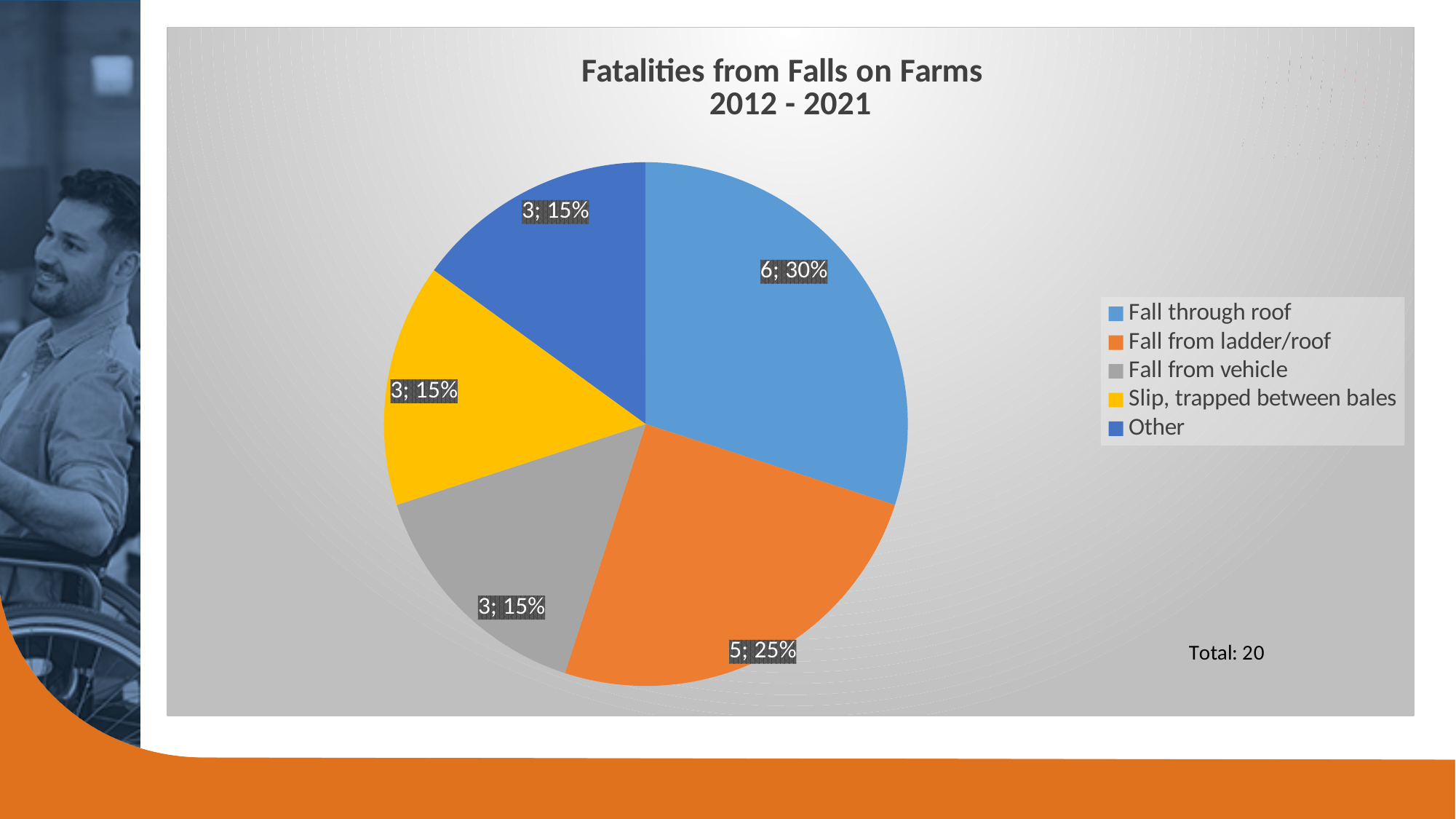
What percentage share does the Other slice have? 15% Which category has the largest slice? Fall through roof How many fatalities are attributed to Fall through roof? 6 What is the title of the chart? Fatalities from Falls on Farms 2012 - 2021 What is the total number of fatalities shown on the slide? 20 What percentage share does Fall from ladder/roof have? 25% What kind of chart is shown on the slide? Pie chart How many categories does the legend list? 5 How many fatalities are attributed to Fall from vehicle? 3 Which is larger, Fall from ladder/roof or Slip, trapped between bales? Fall from ladder/roof What colour represents Slip, trapped between bales in the chart? Yellow What is the difference in fatalities between Fall through roof and Fall from ladder/roof? 1